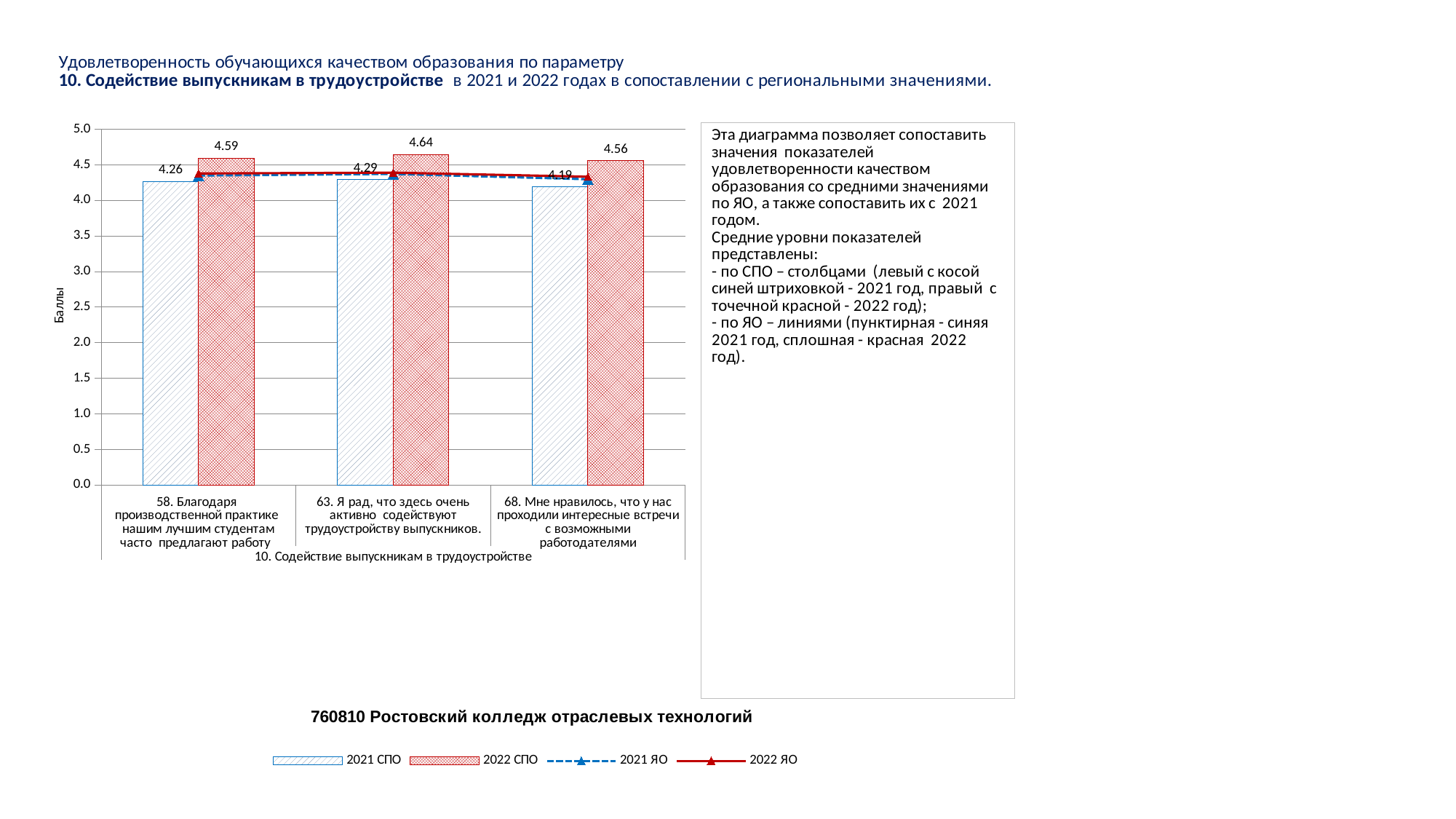
How many series does the chart legend list? 4 How many categories are shown on the x axis of the chart? 3 Which category has the lowest 2021 СПО value? 68. Мне нравилось, что у нас проходили интересные встречи с возможными работодателями What is the difference between the 2022 СПО and 2021 СПО values for category 58? 0.33 What is the value of the 2021 СПО bar for category 58 (Благодаря производственной практике нашим лучшим студентам часто предлагают работу)? 4.26 What is the value of the 2022 СПО bar for category 63 (Я рад, что здесь очень активно содействуют трудоустройству выпускников)? 4.64 Is the 2021 ЯО line value for category 58 greater or less than 4.0? greater Which is larger: the 2022 СПО value for category 58 or for category 68? Category 58 (4.59) What is the value of the 2022 СПО bar for category 68 (Мне нравилось, что у нас проходили интересные встречи с возможными работодателями)? 4.56 Which category has the highest 2022 СПО value? 63. Я рад, что здесь очень активно содействуют трудоустройству выпускников. What is the title of the vertical axis of the chart? Баллы What kind of chart is used for the СПО series? bar chart